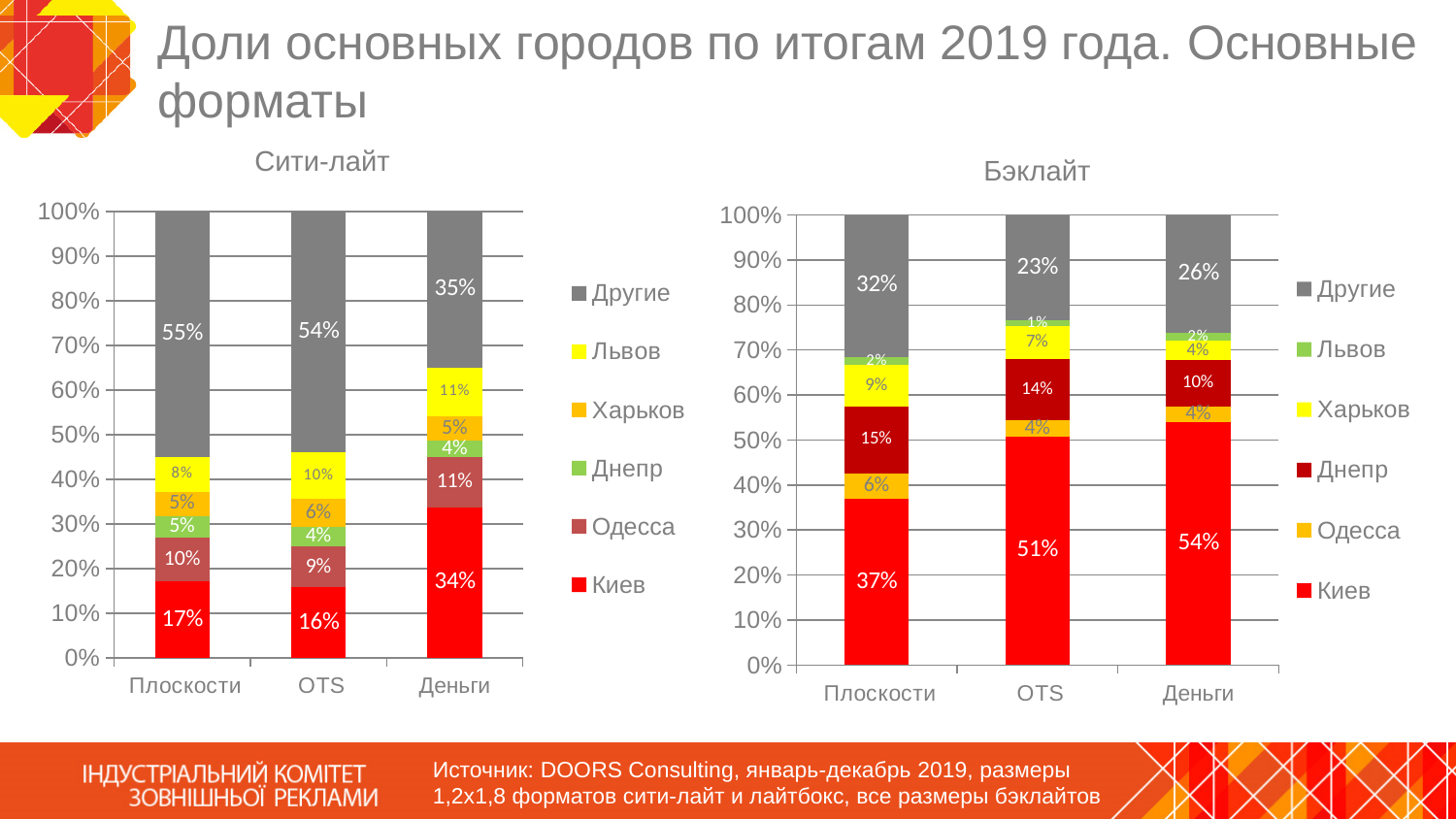
On the Бэклайт chart, what is the difference between the Другие values for Плоскости and OTS? 9% On the Сити-лайт chart, what is the value for Киев in the Деньги bar? 34% On the Бэклайт chart, which series is shown in red? Киев On the Бэклайт chart, what is the value for Киев in the OTS bar? 51% How many categories are shown on the x axis of the Сити-лайт chart? 3 On the Бэклайт chart, what is the value for Днепр in the Плоскости bar? 15% On the Бэклайт chart, which category has the highest value for Киев? Деньги On the Сити-лайт chart, what is the value for Другие in the Плоскости bar? 55% What kind of chart is the Бэклайт chart? Stacked bar chart On the Сити-лайт chart, which category has the lowest value for Другие? Деньги How many series does the legend of the Бэклайт chart list? 6 On the Сити-лайт chart, which is larger: Одесса in Плоскости or Одесса in OTS? Одесса in Плоскости